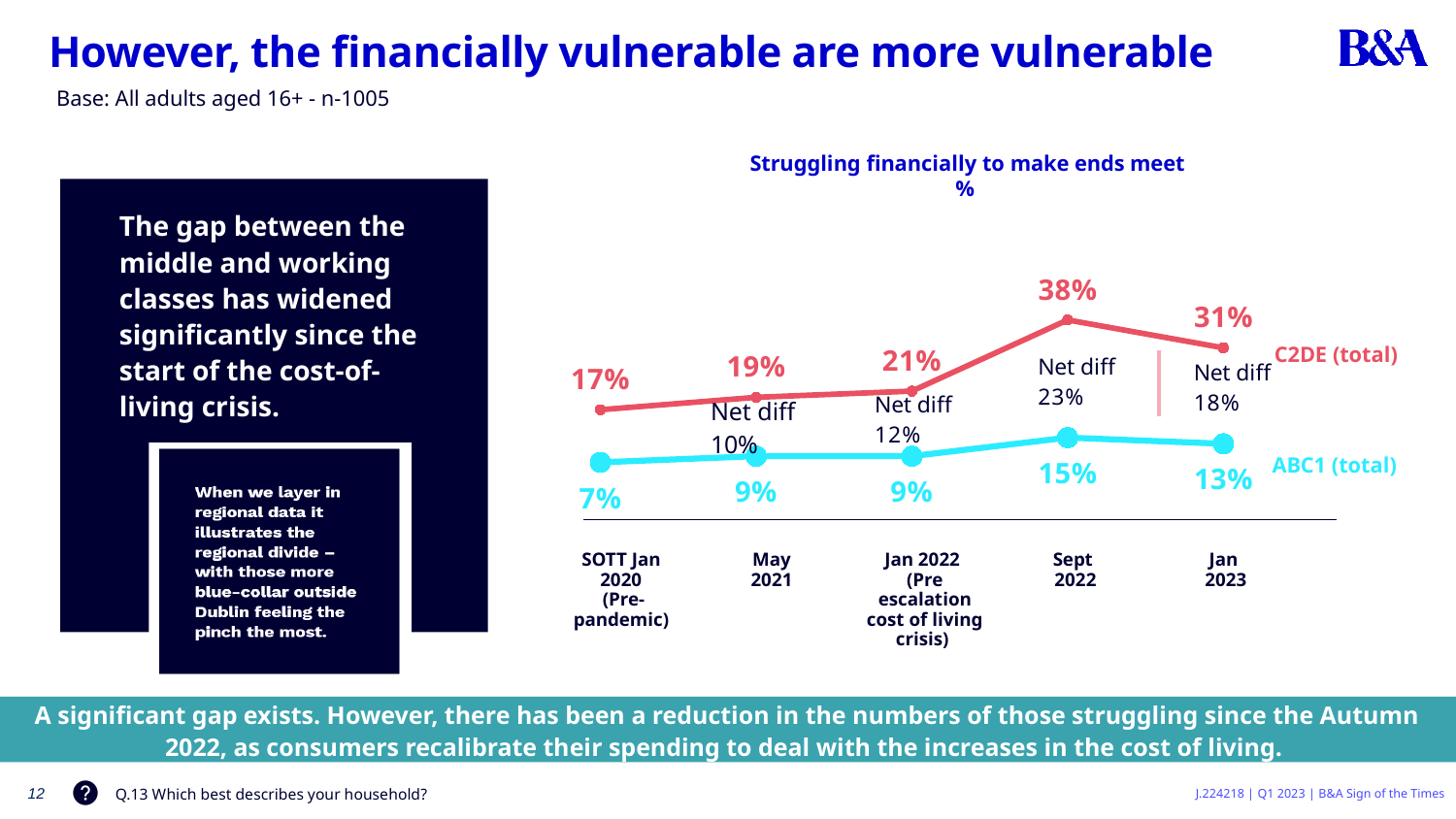
How many time points are plotted on the x axis? 5 What is the title of the chart? Struggling financially to make ends meet % Which is larger in Jan 2022: the C2DE (total) value or the ABC1 (total) value? C2DE (total) At which time point is the C2DE (total) value highest? Sept 2022 How many series are plotted on the chart? 2 What is the value for ABC1 (total) in Jan 2023? 13% What is the value for C2DE (total) in Sept 2022? 38% What is the difference between the C2DE (total) and ABC1 (total) values in Jan 2023? 18% At which time point is the ABC1 (total) value lowest? SOTT Jan 2020 (Pre-pandemic) What is the value for C2DE (total) at SOTT Jan 2020 (Pre-pandemic)? 17% What is the value for ABC1 (total) in May 2021? 9% What type of chart is shown on the slide? Line chart